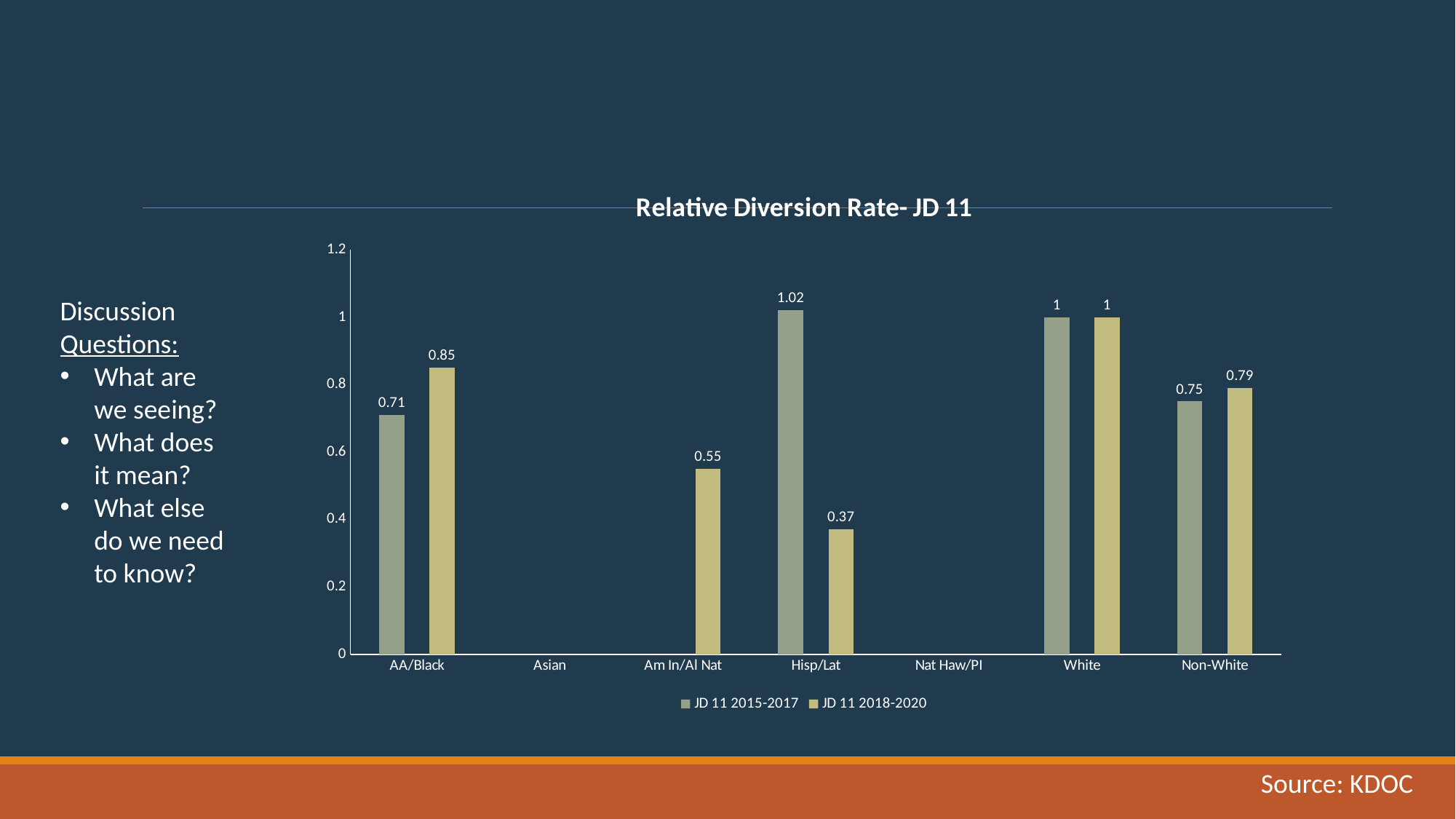
Which category has the highest value in the JD 11 2015-2017 series? Hisp/Lat What is the value for AA/Black in the JD 11 2015-2017 series? 0.71 Which is larger for Non-White: the JD 11 2015-2017 value or the JD 11 2018-2020 value? JD 11 2018-2020 How many series does the legend list? 2 What is the title of the chart? Relative Diversion Rate- JD 11 What is the value for Am In/Al Nat in the JD 11 2018-2020 series? 0.55 Which category has the lowest labelled value in the JD 11 2018-2020 series? Hisp/Lat How many categories are shown on the x axis? 7 What kind of chart is shown on the slide? Bar chart What is the value for AA/Black in the JD 11 2018-2020 series? 0.85 What is the value for Hisp/Lat in the JD 11 2018-2020 series? 0.37 What is the difference between the JD 11 2015-2017 and JD 11 2018-2020 values for Hisp/Lat? 0.65